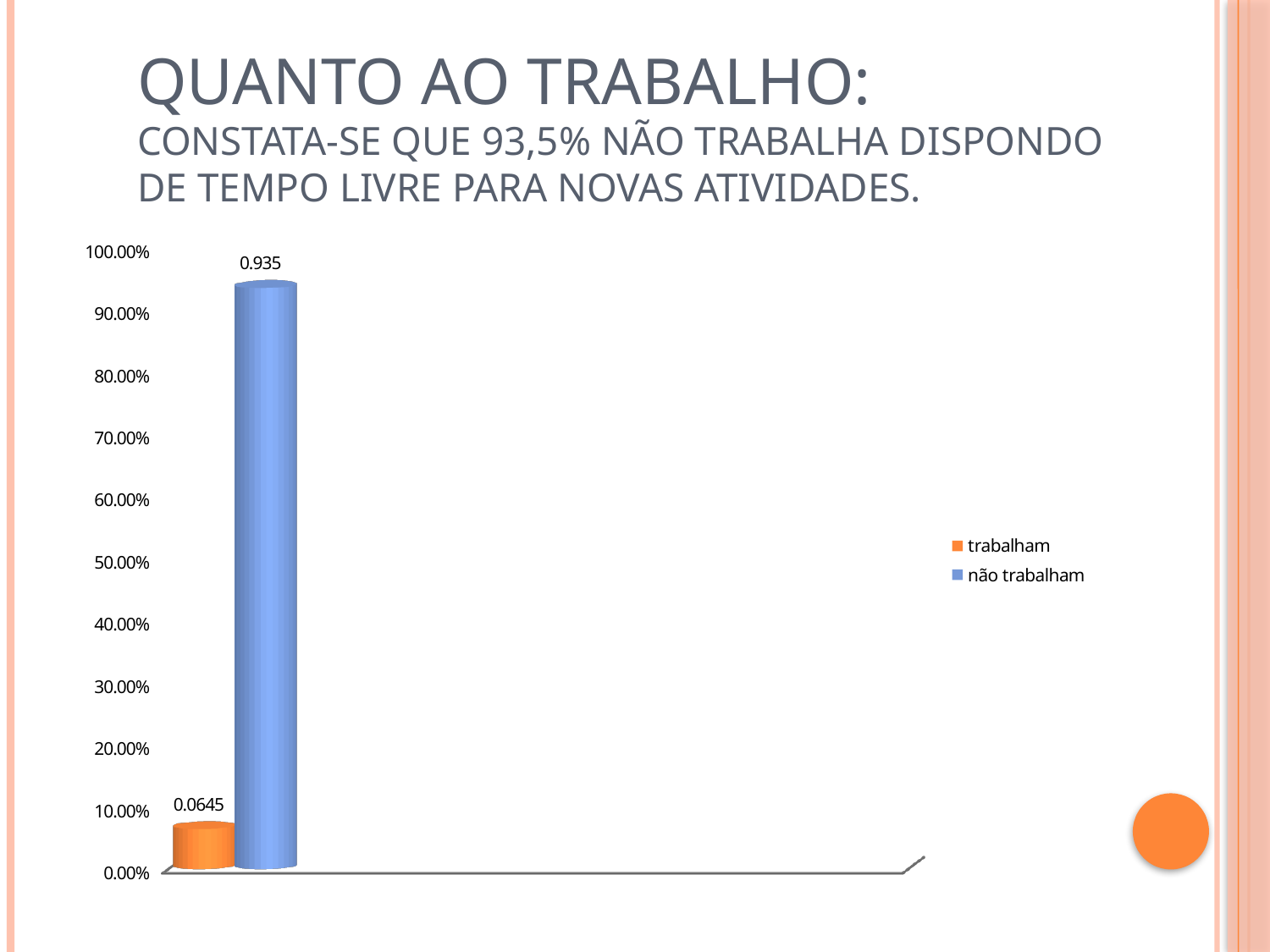
What kind of chart is shown on the slide? bar chart What colour is the bar for "trabalham"? orange How many bars are plotted in the chart? 2 Which series has the taller bar, "trabalham" or "não trabalham"? não trabalham What is the data label shown on the bar for "trabalham"? 0.0645 Which series has the lowest value in the chart? trabalham Which series has the highest value in the chart? não trabalham Is the value for "trabalham" greater or less than 10.00%? less What is the highest value shown on the vertical axis? 100.00% What is the data label shown on the bar for "não trabalham"? 0.935 How many series does the legend list? 2 Is the value for "não trabalham" greater or less than 90.00%? greater